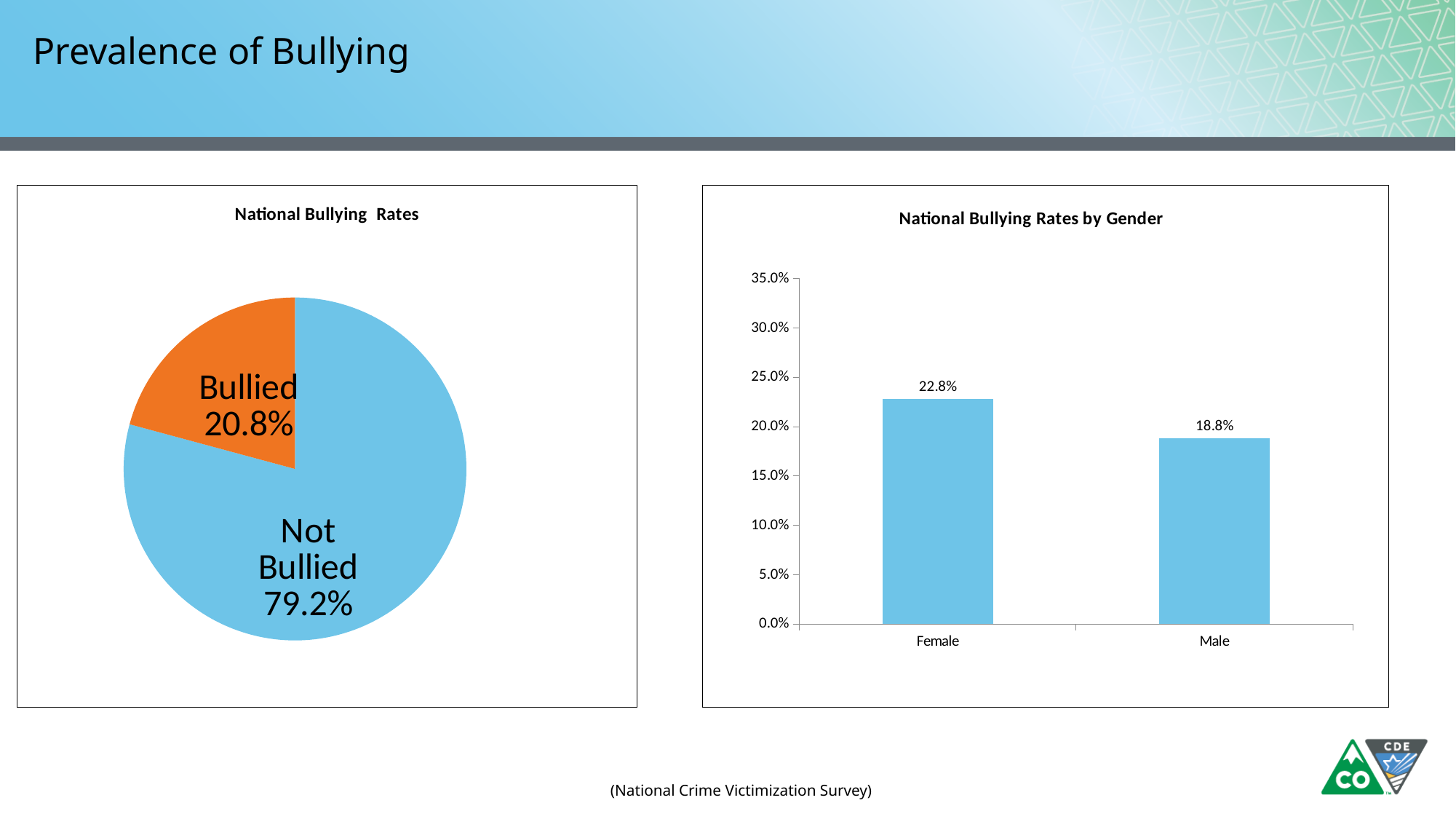
In the 'National Bullying Rates' pie chart, what share of the pie is labelled 'Bullied'? 20.8% In the 'National Bullying Rates by Gender' chart, what is the value for Male? 18.8% In the 'National Bullying Rates' pie chart, what share of the pie is labelled 'Not Bullied'? 79.2% What kind of chart is the 'National Bullying Rates by Gender' chart on the right? Bar chart In the 'National Bullying Rates' pie chart, which slice is larger, 'Bullied' or 'Not Bullied'? Not Bullied In the 'National Bullying Rates by Gender' chart, is the value for Male greater or less than 20.0%? less In the 'National Bullying Rates by Gender' chart, what is the value for Female? 22.8% What kind of chart is the 'National Bullying Rates' chart on the left? Pie chart In the 'National Bullying Rates' pie chart, what colour is the 'Bullied' slice? Orange In the 'National Bullying Rates' pie chart, how many slices does the pie have? 2 In the 'National Bullying Rates by Gender' chart, which category has the highest value? Female In the 'National Bullying Rates by Gender' chart, what is the difference between the Female and Male values? 4.0%